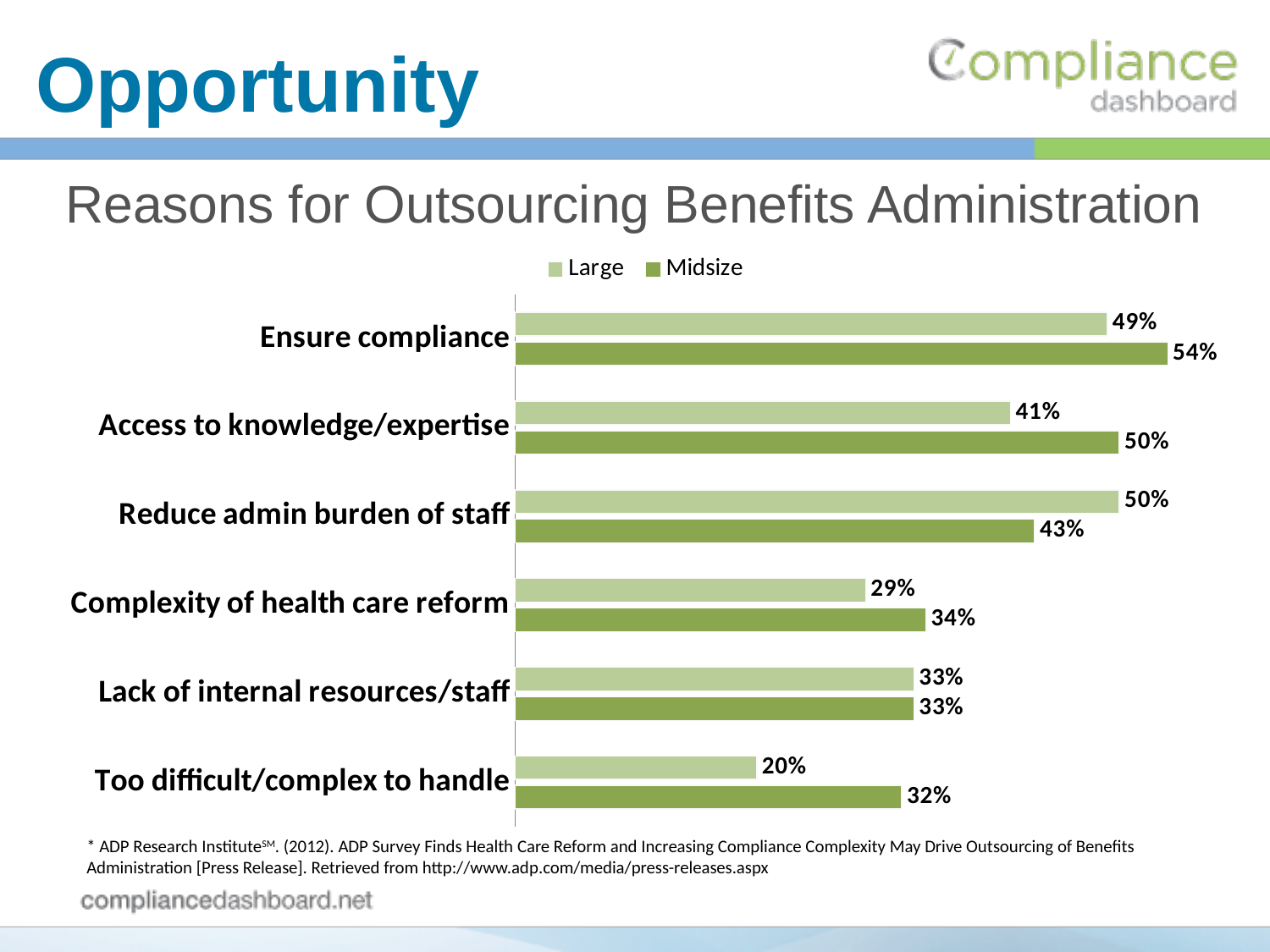
What is the Large value for Too difficult/complex to handle? 20% What is the Large value for Reduce admin burden of staff? 50% What is the title of the chart? Reasons for Outsourcing Benefits Administration Which category has the highest Midsize value? Ensure compliance How many categories are shown in the chart? 6 How many series does the legend list? 2 Which is larger for Reduce admin burden of staff, the Large value or the Midsize value? Large Which category has the lowest Large value? Too difficult/complex to handle What kind of chart is shown on the slide? Bar chart What is the Midsize value for Ensure compliance? 54% What is the difference between the Midsize and Large values for Too difficult/complex to handle? 12% What are the two series listed in the legend? Large and Midsize